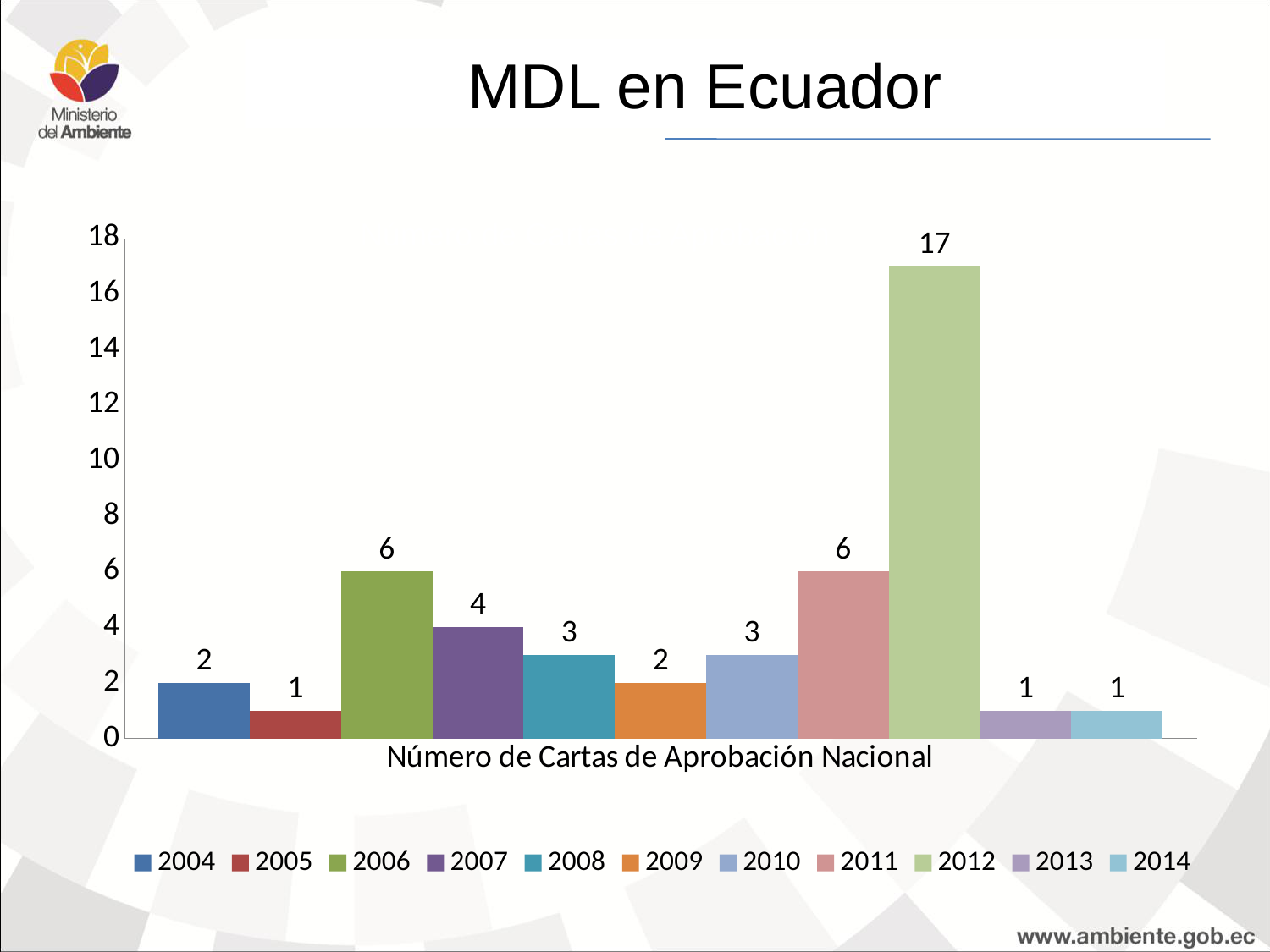
What is the value for 2009? 2 What is the value for 2006? 6 Is the value for 2012 greater or less than 10? greater Which is larger, the value for 2007 or the value for 2008? 2007 What is the value for 2012? 17 What type of chart is shown on the slide? bar chart What is the difference between the values for 2007 and 2005? 3 How many series does the legend list? 11 What is the value for 2007? 4 What is the difference between the values for 2012 and 2011? 11 What is the label shown on the x axis below the bars? Número de Cartas de Aprobación Nacional Which year has the highest value? 2012